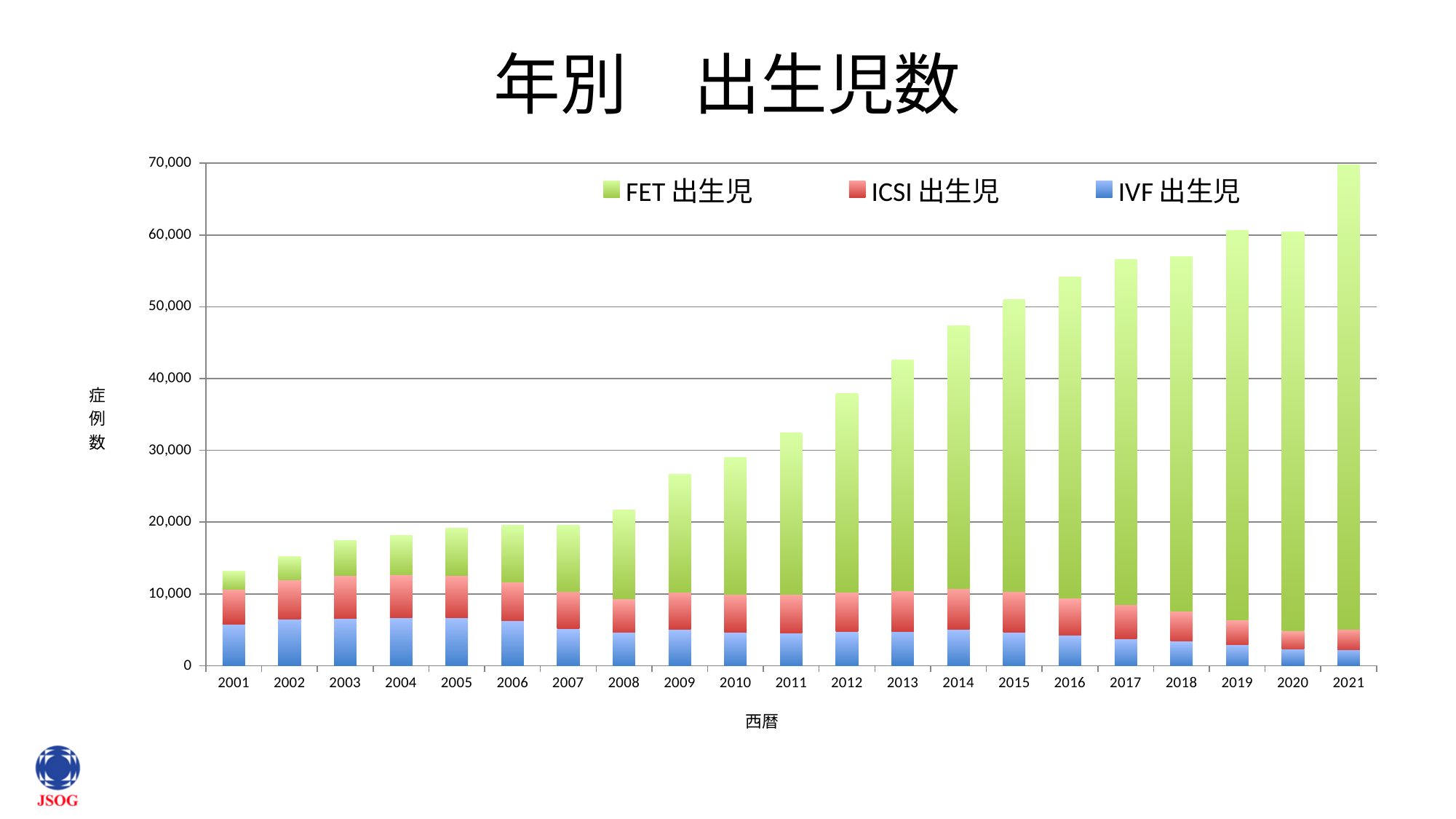
Which year has the larger total bar, 2012 or 2013? 2013 Which year has the lowest total bar? 2001 What kind of chart is shown on the slide? stacked bar chart What is the title of the chart? 年別 出生児数 How many series does the legend list? 3 Do the total bar heights generally rise or fall from 2001 to 2021? rise Is the total bar for 2010 greater or less than 30,000? less Is the total bar for 2013 greater or less than 40,000? greater Is the total bar for 2017 greater or less than 60,000? less Which year has the highest total bar? 2021 Which series is shown in green in the legend? FET 出生児 How many years are shown on the x axis? 21